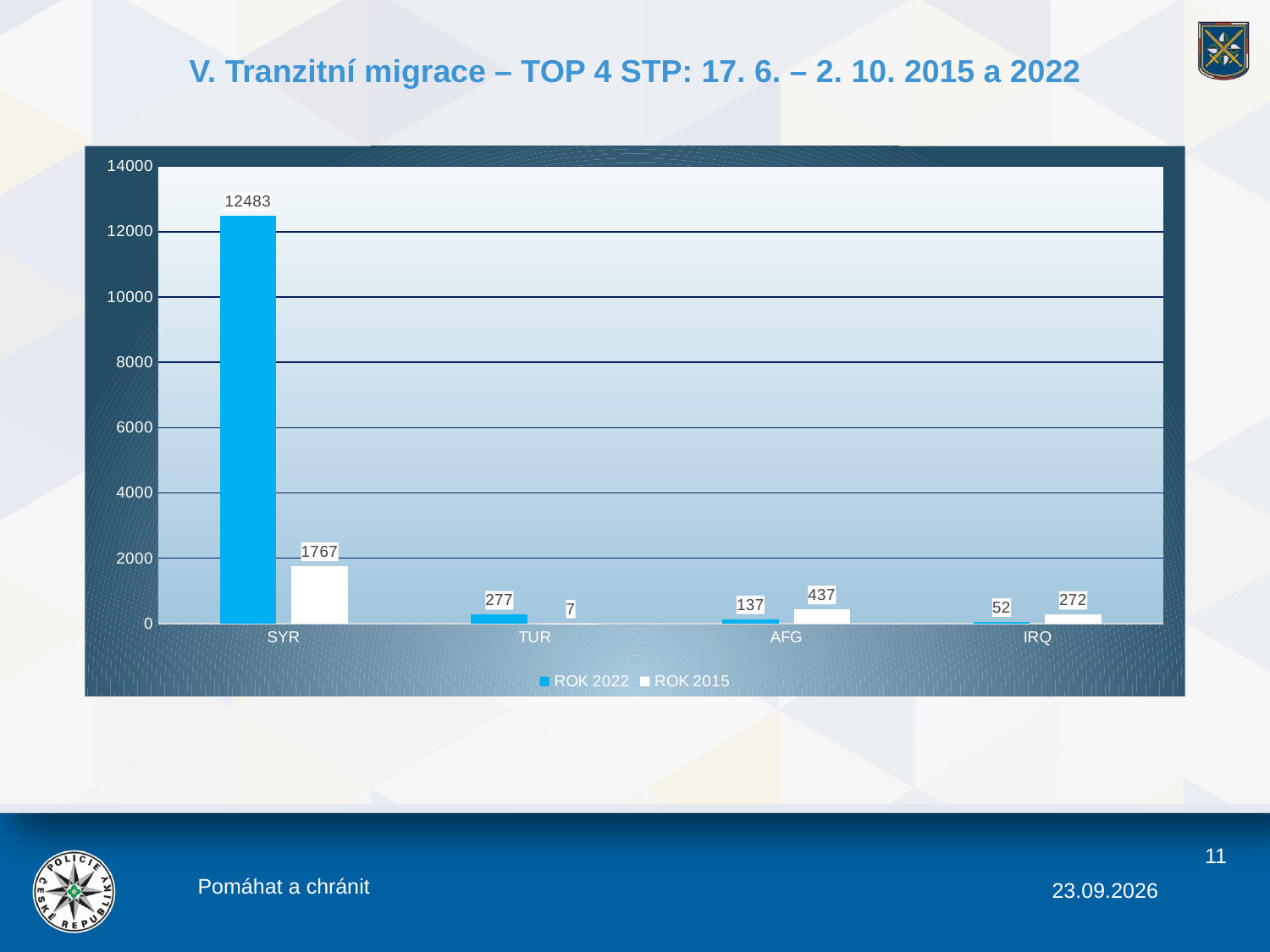
Which is larger for AFG: the ROK 2022 value or the ROK 2015 value? ROK 2015 What is the value for SYR in the ROK 2015 series? 1767 What is the value for IRQ in the ROK 2015 series? 272 What is the value for SYR in the ROK 2022 series? 12483 How many series does the legend list? 2 What is the value for TUR in the ROK 2015 series? 7 Which category has the lowest value in the ROK 2015 series? TUR What is the difference between the ROK 2022 and ROK 2015 values for SYR? 10716 Which category has the highest value in the ROK 2022 series? SYR What is the value for AFG in the ROK 2022 series? 137 How many categories are shown on the x axis? 4 What kind of chart is shown on the slide? Bar chart